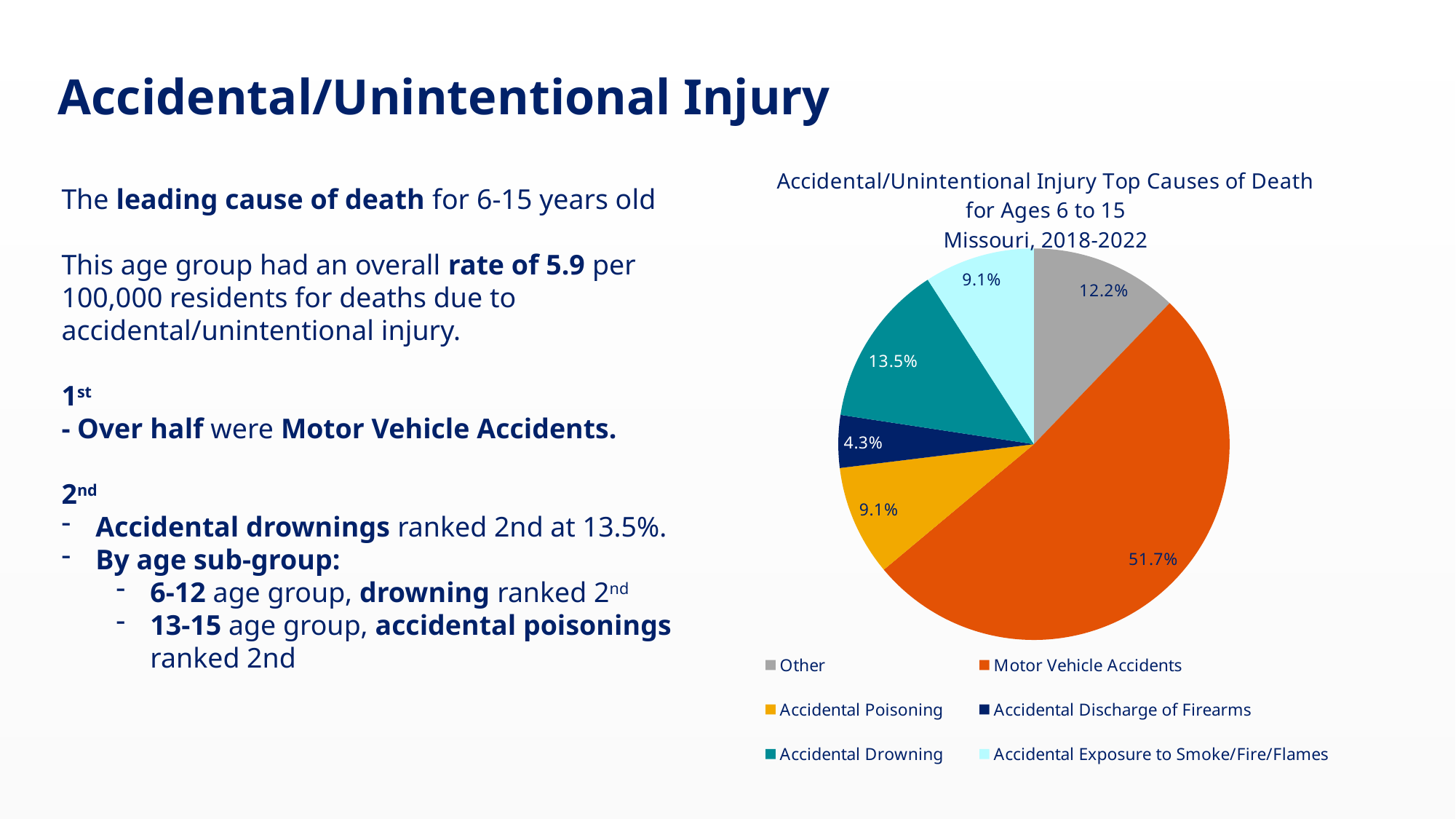
What share of the pie is Accidental Poisoning? 9.1% What is the difference in percentage points between Motor Vehicle Accidents and Accidental Drowning? 38.2 What share of the pie is Accidental Drowning? 13.5% What share of the pie is Motor Vehicle Accidents? 51.7% Which is larger, the share for Other or the share for Accidental Drowning? Accidental Drowning Which cause of death has the smallest slice of the pie? Accidental Discharge of Firearms Which years does the pie chart title say the data covers? 2018-2022 How many categories does the pie chart legend list? 6 What share of the pie is Accidental Discharge of Firearms? 4.3% Which cause of death has the largest slice of the pie? Motor Vehicle Accidents What type of chart is shown on the slide? Pie chart What share of the pie is the Other category? 12.2%